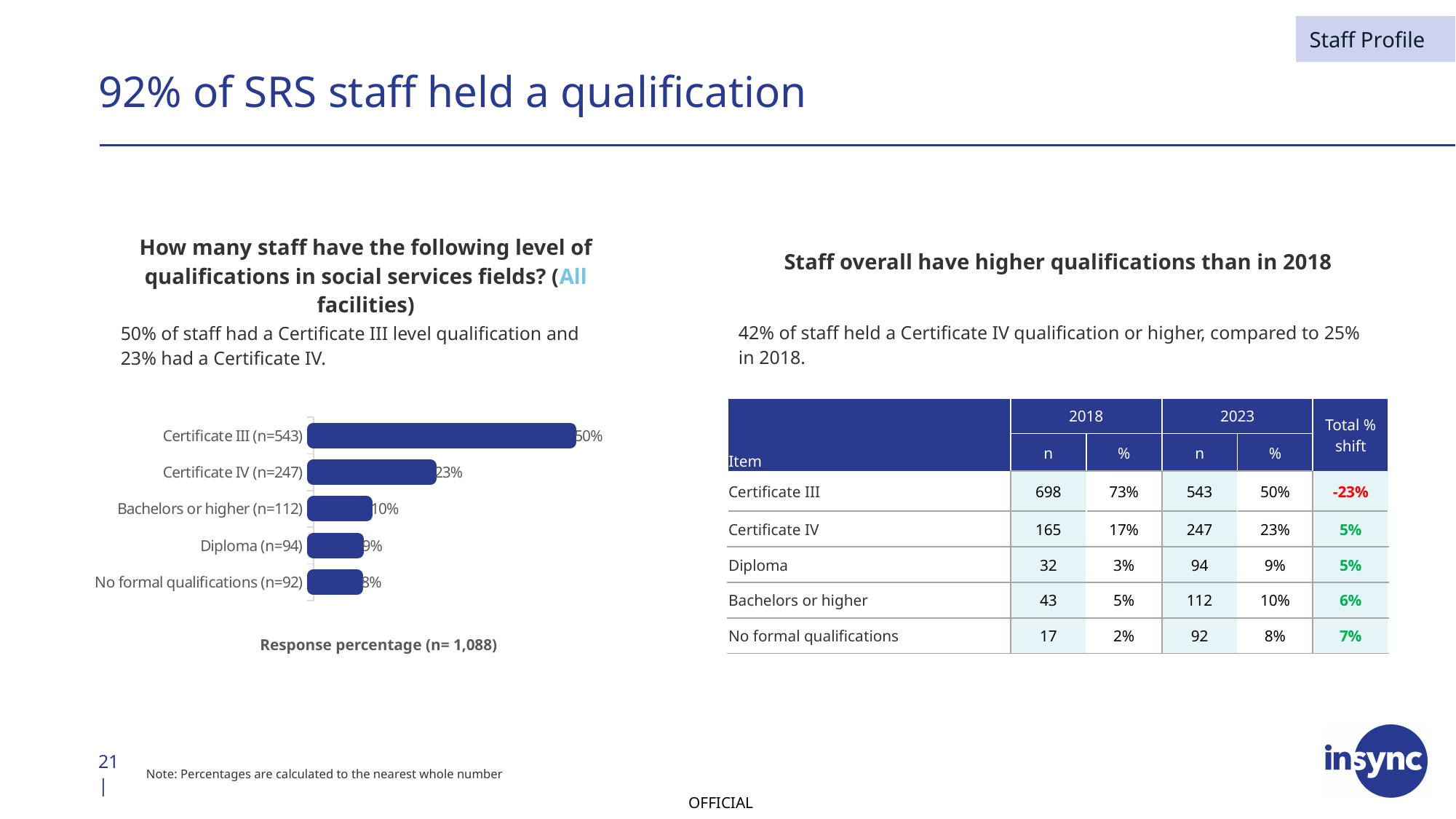
What is the value for Certificate IV (n=247) in the bar chart? 23% What is the difference between the values for Certificate III (n=543) and Certificate IV (n=247) in the bar chart? 27% How many categories are shown in the bar chart? 5 What is the axis label shown beneath the bar chart? Response percentage (n= 1,088) Which category has the highest value in the bar chart? Certificate III (n=543) Which category has the lowest value in the bar chart? No formal qualifications (n=92) What kind of chart is shown on the left of the slide? Bar chart Which is larger in the bar chart, the value for Diploma (n=94) or the value for No formal qualifications (n=92)? Diploma (n=94) What is the value for Diploma (n=94) in the bar chart? 9% What is the value for Bachelors or higher (n=112) in the bar chart? 10% What is the value for Certificate III (n=543) in the bar chart? 50% What is the value for No formal qualifications (n=92) in the bar chart? 8%